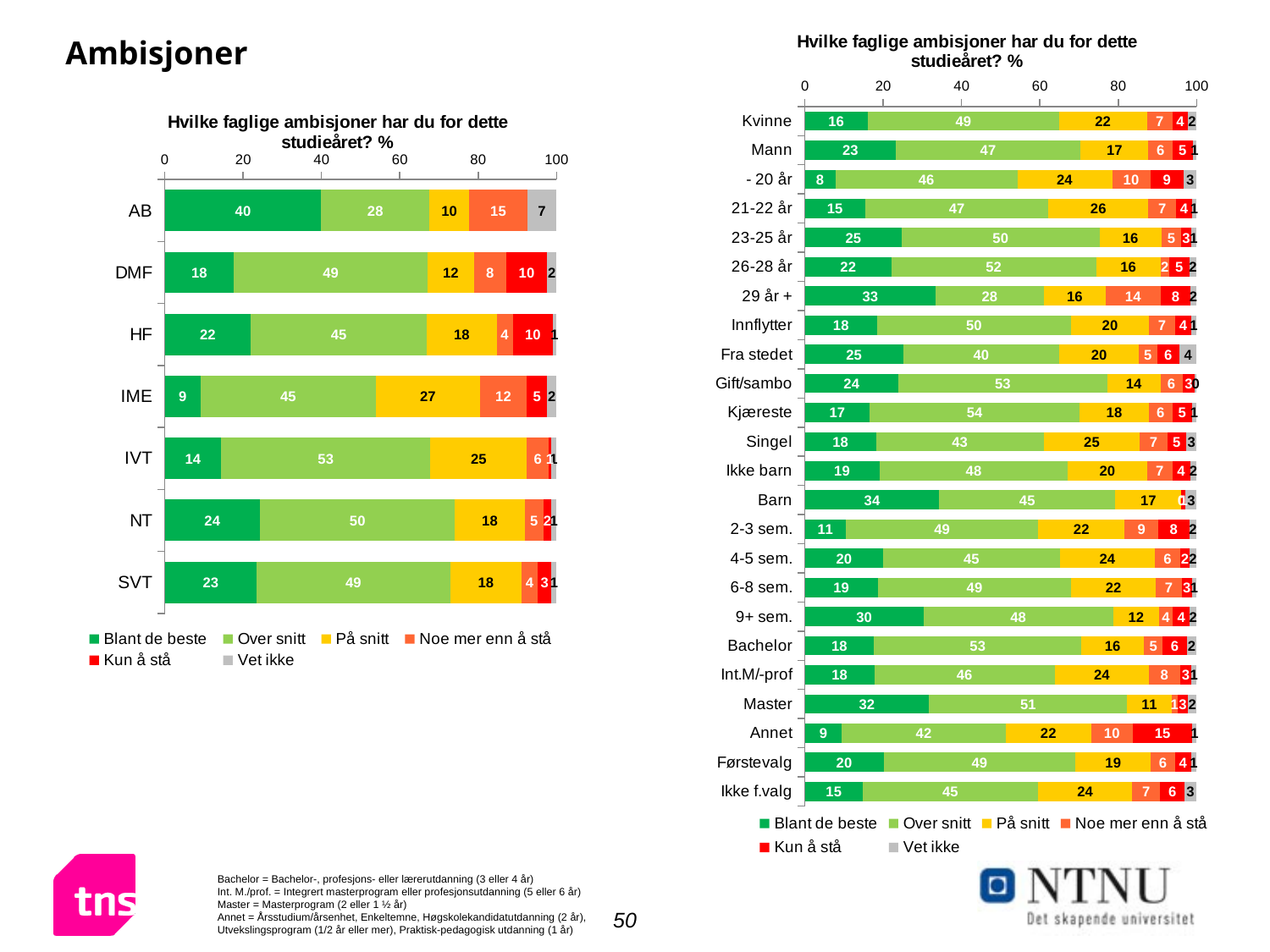
On the right chart, what is the value of 'Kun å stå' for Annet? 15 On the left chart, what is the value of 'Over snitt' for IVT? 53 On the right chart, what is the value of 'Blant de beste' for '29 år +'? 33 On the left chart, which category has the highest value for 'Blant de beste'? AB On the left chart, what is the difference between the 'Over snitt' values for IVT and AB? 25 On the right chart, what is the value of 'Over snitt' for Kjæreste? 54 On the right chart, which has the larger 'Blant de beste' value, Kvinne or Mann? Mann What kind of chart is the right chart? Bar chart How many series does the legend of the left chart list? 6 On the left chart, which category has the lowest value for 'Blant de beste'? IME How many categories are shown on the left chart? 7 On the left chart, what is the value of 'Blant de beste' for AB? 40